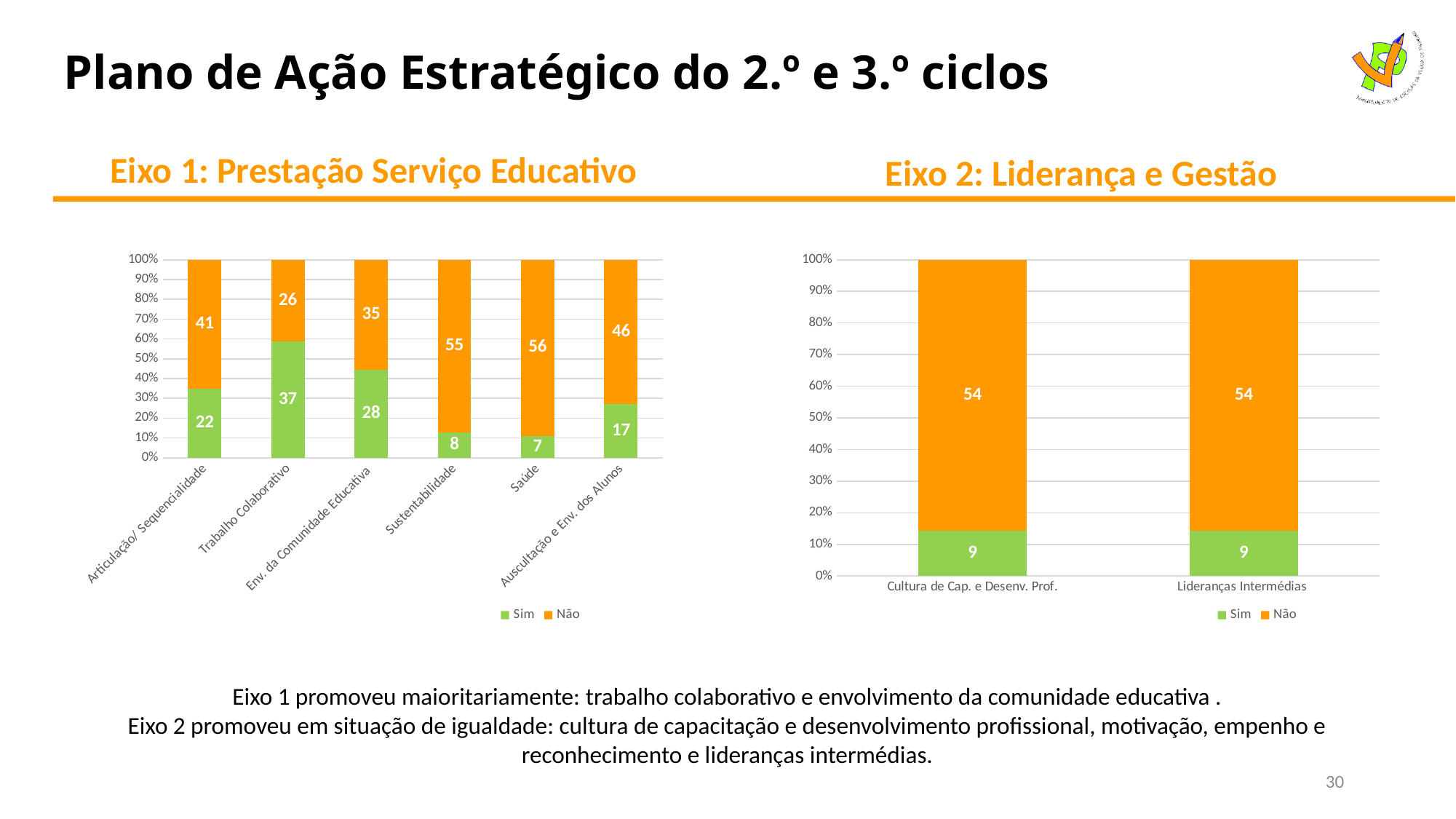
In the Eixo 1: Prestação Serviço Educativo chart, what is the total of the Sim and Não values for Articulação/ Sequencialidade? 63 How many series does the legend of the Eixo 2: Liderança e Gestão chart list? 2 In the Eixo 1: Prestação Serviço Educativo chart, which category has the highest Sim value? Trabalho Colaborativo What type of chart is the Eixo 2: Liderança e Gestão chart? Stacked bar chart In the Eixo 1: Prestação Serviço Educativo chart, what is the Não value for Saúde? 56 In the Eixo 2: Liderança e Gestão chart, what is the Não value for Lideranças Intermédias? 54 How many categories are shown in the Eixo 1: Prestação Serviço Educativo chart? 6 In the Eixo 1: Prestação Serviço Educativo chart, which is larger for Env. da Comunidade Educativa: the Sim value or the Não value? Não In the Eixo 1: Prestação Serviço Educativo chart, what is the difference between the Não and Sim values for Sustentabilidade? 47 In the Eixo 1: Prestação Serviço Educativo chart, what is the Sim value for Trabalho Colaborativo? 37 In the Eixo 2: Liderança e Gestão chart, what is the Sim value for Cultura de Cap. e Desenv. Prof.? 9 In the Eixo 1: Prestação Serviço Educativo chart, which category has the lowest Sim value? Saúde